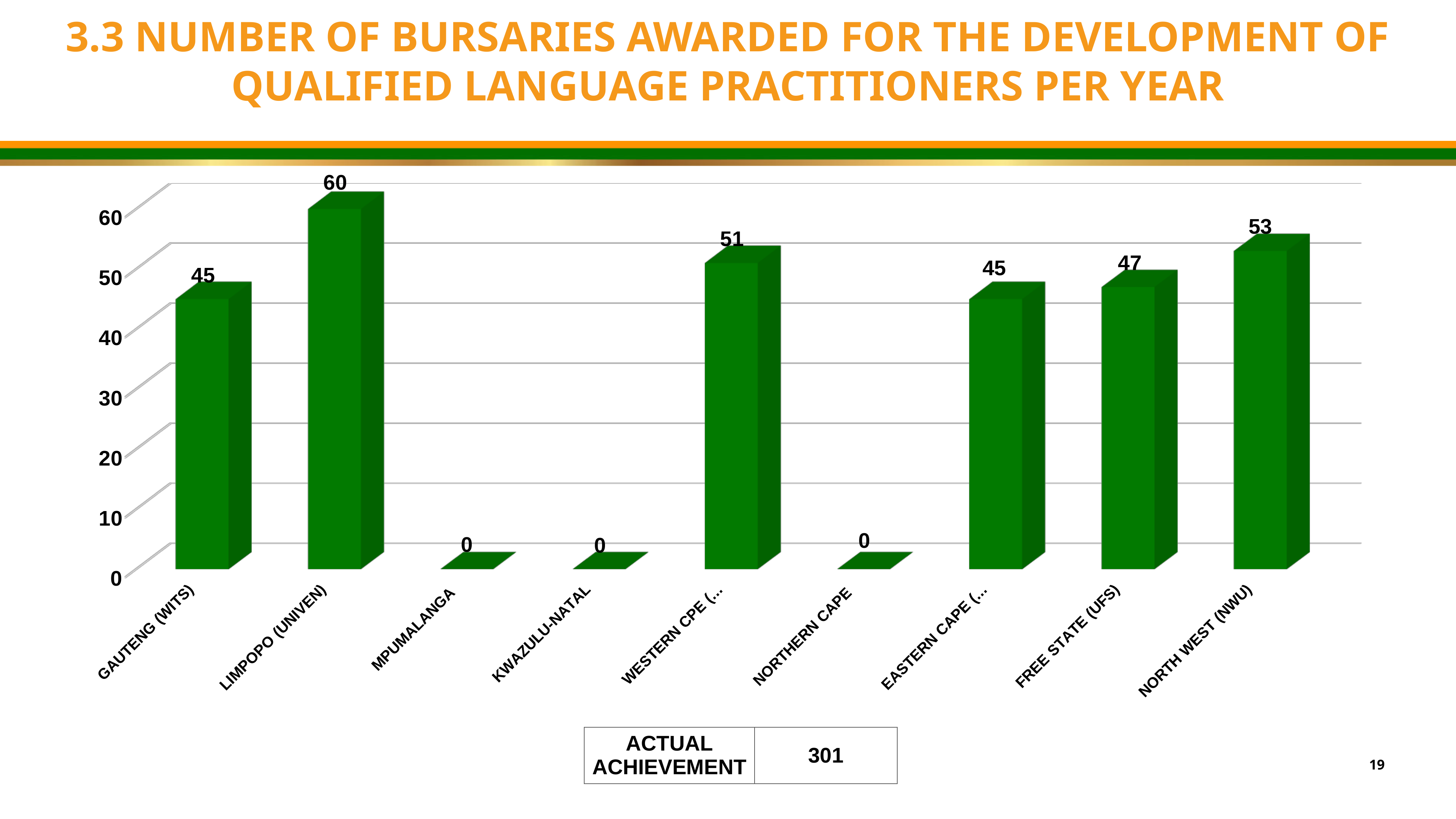
What is the value for NORTHERN CAPE? 0 How many categories are shown on the x axis? 9 What is the difference between the values for FREE STATE (UFS) and GAUTENG (WITS)? 2 What is the value for GAUTENG (WITS)? 45 What is the difference between the values for LIMPOPO (UNIVEN) and NORTH WEST (NWU)? 7 What kind of chart is shown on the slide? bar chart What is the value for LIMPOPO (UNIVEN)? 60 How many categories have a value of 0? 3 Which category has the highest value? LIMPOPO (UNIVEN) What is the value for NORTH WEST (NWU)? 53 What is the value for FREE STATE (UFS)? 47 Which is larger, the value for NORTH WEST (NWU) or the value for FREE STATE (UFS)? NORTH WEST (NWU)